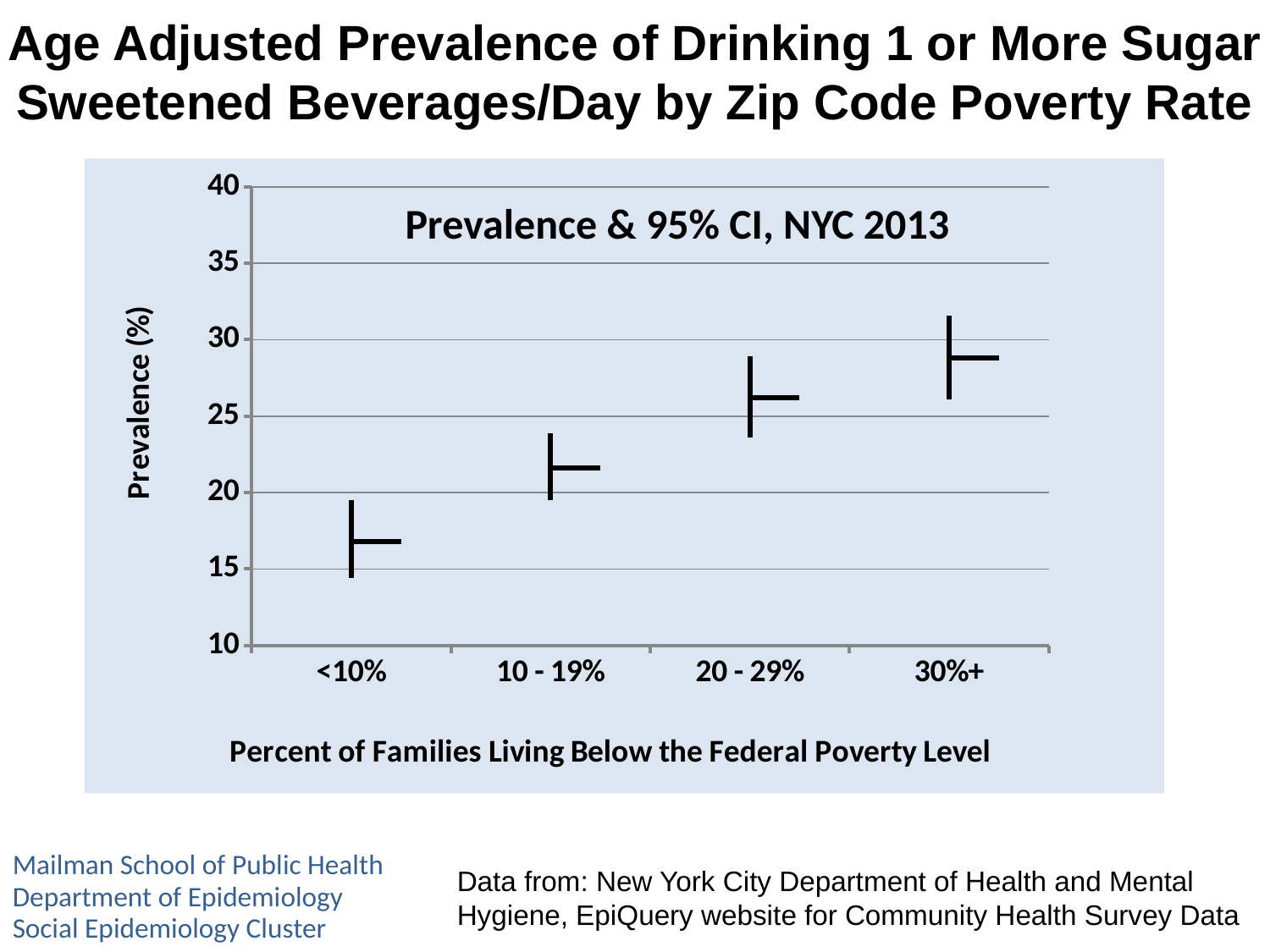
What is the label of the x axis? Percent of Families Living Below the Federal Poverty Level Which poverty-rate category has the highest prevalence? 30%+ Is the prevalence for the 20 - 29% category greater or less than 25? greater Do prevalence values rise or fall as the zip code poverty rate increases along the x axis? rise How many poverty-rate categories are plotted on the x axis? 4 What is the highest value shown on the y axis? 40 Is the prevalence for the <10% category greater or less than 20? less Which has the higher prevalence, the 10 - 19% category or the 20 - 29% category? 20 - 29% What is the title printed inside the chart area? Prevalence & 95% CI, NYC 2013 Which poverty-rate category has the lowest prevalence? <10% Is the prevalence for the 10 - 19% category greater or less than 25? less